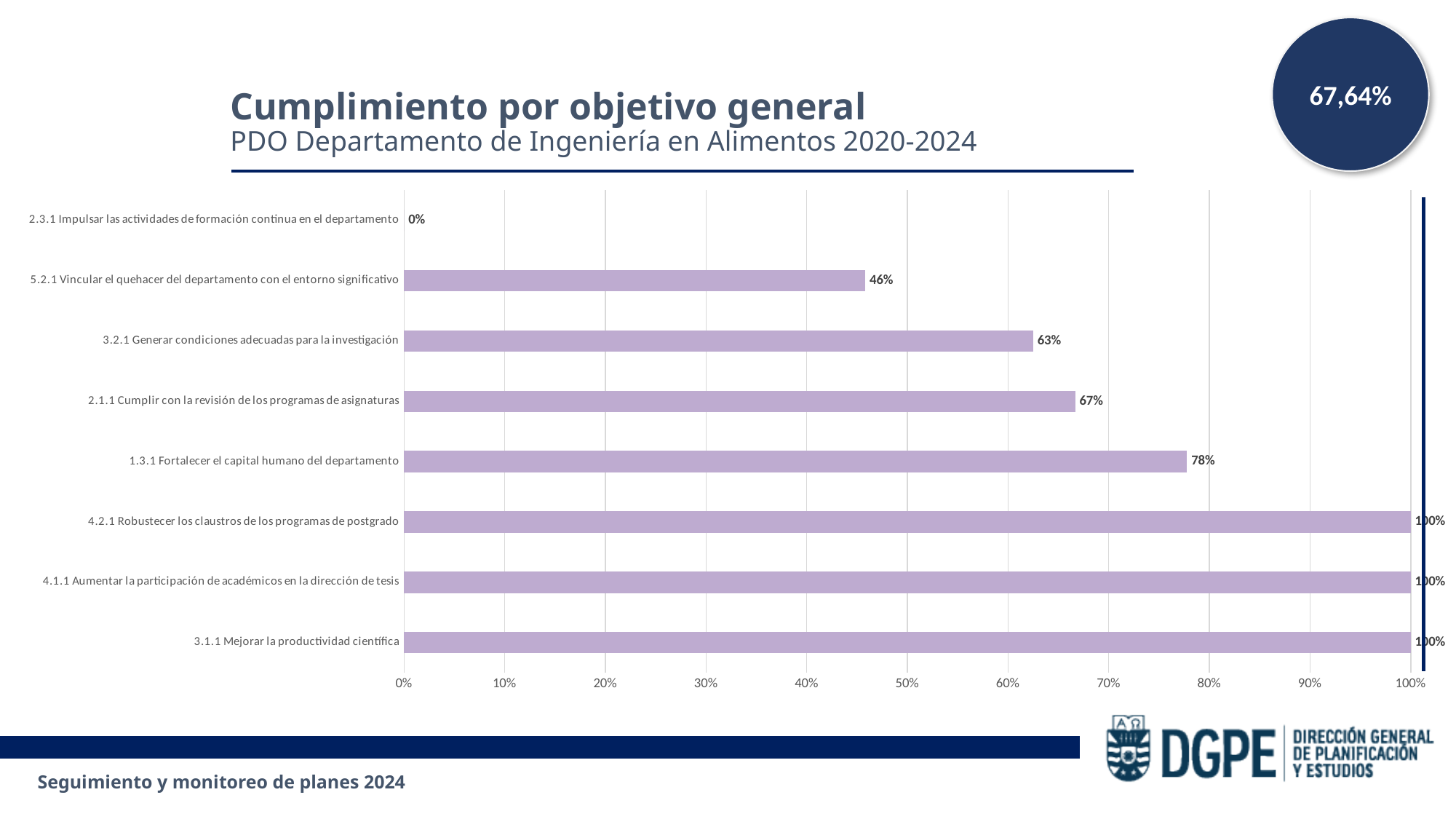
Which objective has the lowest value? 2.3.1 Impulsar las actividades de formación continua en el departamento What overall percentage is shown in the circle at the top right of the slide? 67,64% What is the value for 5.2.1 Vincular el quehacer del departamento con el entorno significativo? 46% How many objectives are shown in the chart? 8 How many objectives have a value of 100%? 3 What is the value for 2.3.1 Impulsar las actividades de formación continua en el departamento? 0% What kind of chart is shown on the slide? Bar chart What is the difference between the values for 1.3.1 Fortalecer el capital humano del departamento and 5.2.1 Vincular el quehacer del departamento con el entorno significativo? 32% What is the title of the chart? Cumplimiento por objetivo general Which is larger, the value for 2.1.1 Cumplir con la revisión de los programas de asignaturas or the value for 3.2.1 Generar condiciones adecuadas para la investigación? 2.1.1 Cumplir con la revisión de los programas de asignaturas What is the value for 3.2.1 Generar condiciones adecuadas para la investigación? 63% What is the value for 1.3.1 Fortalecer el capital humano del departamento? 78%